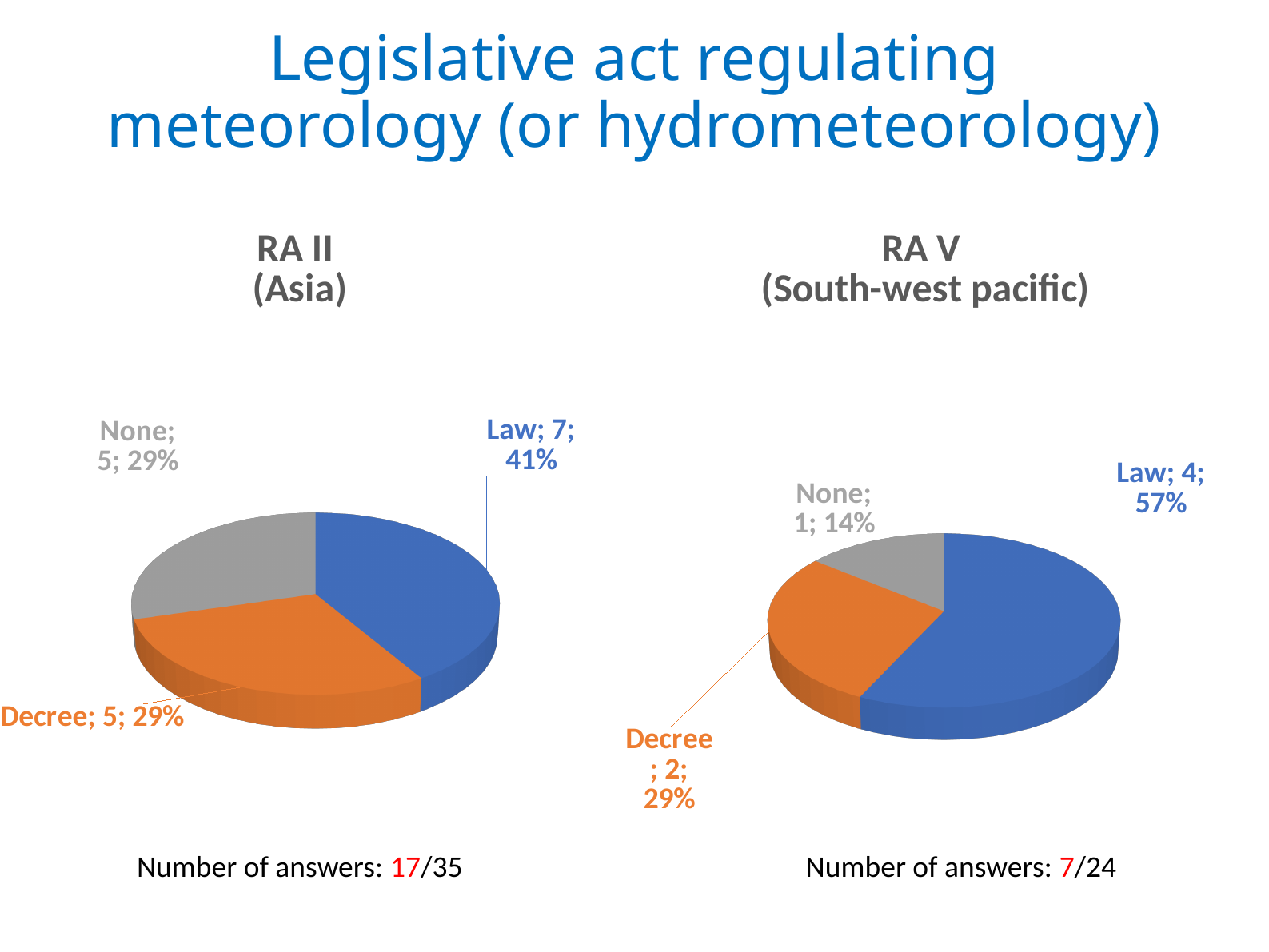
What kind of chart is the RA II (Asia) chart? Pie chart In the RA II (Asia) chart, what is the difference between the Law count and the Decree count? 2 In the RA V (South-west pacific) chart, what colour is the Decree slice? Orange In the RA V (South-west pacific) chart, what percentage share does the Law slice have? 57% In the RA V (South-west pacific) chart, how many answers are in the Decree category? 2 In the RA II (Asia) chart, how many categories are shown? 3 In the RA II (Asia) chart, what percentage share does the None slice have? 29% In the RA II (Asia) chart, which category has the largest slice? Law In the RA V (South-west pacific) chart, which is larger, Law or Decree? Law In the RA V (South-west pacific) chart, which category has the smallest slice? None In the RA II (Asia) chart, how many answers are in the Law category? 7 In the RA V (South-west pacific) chart, what is the difference between the Law count and the None count? 3